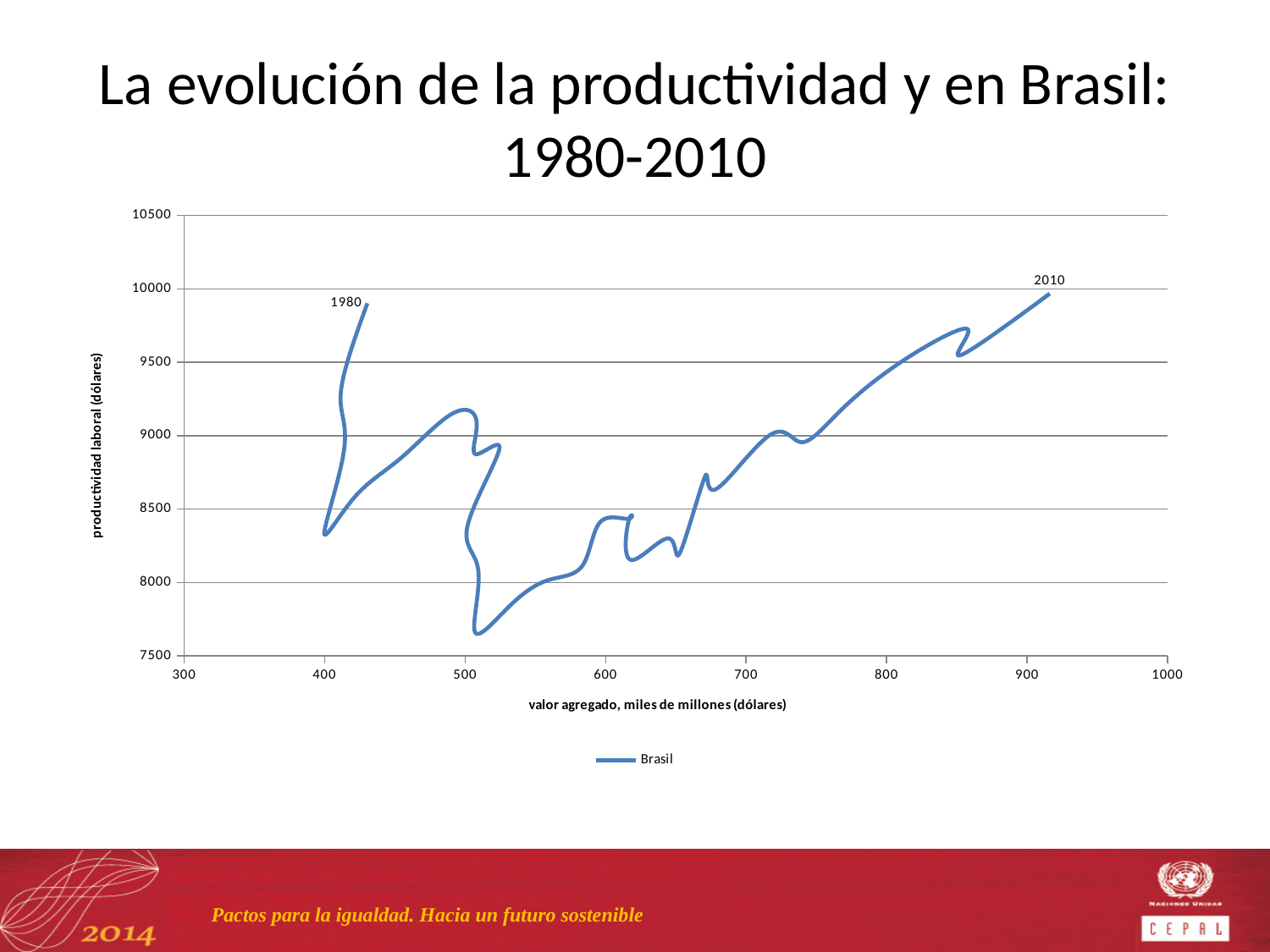
What is the name of the series shown in the legend? Brasil Is the productividad laboral at the point labelled 2010 greater or less than 9500? greater What is the label of the vertical axis? productividad laboral (dólares) What kind of chart is shown on the slide? line chart Is the lowest productividad laboral value reached by the line greater or less than 8000? less Between 700 and 900 on the horizontal axis, does the line generally rise or fall? rise Is the valor agregado at the point labelled 2010 greater or less than 900? greater How many series does the legend list? 1 Is the valor agregado at the point labelled 2010 larger or smaller than at the point labelled 1980? larger Which two year labels are printed on the line? 1980 and 2010